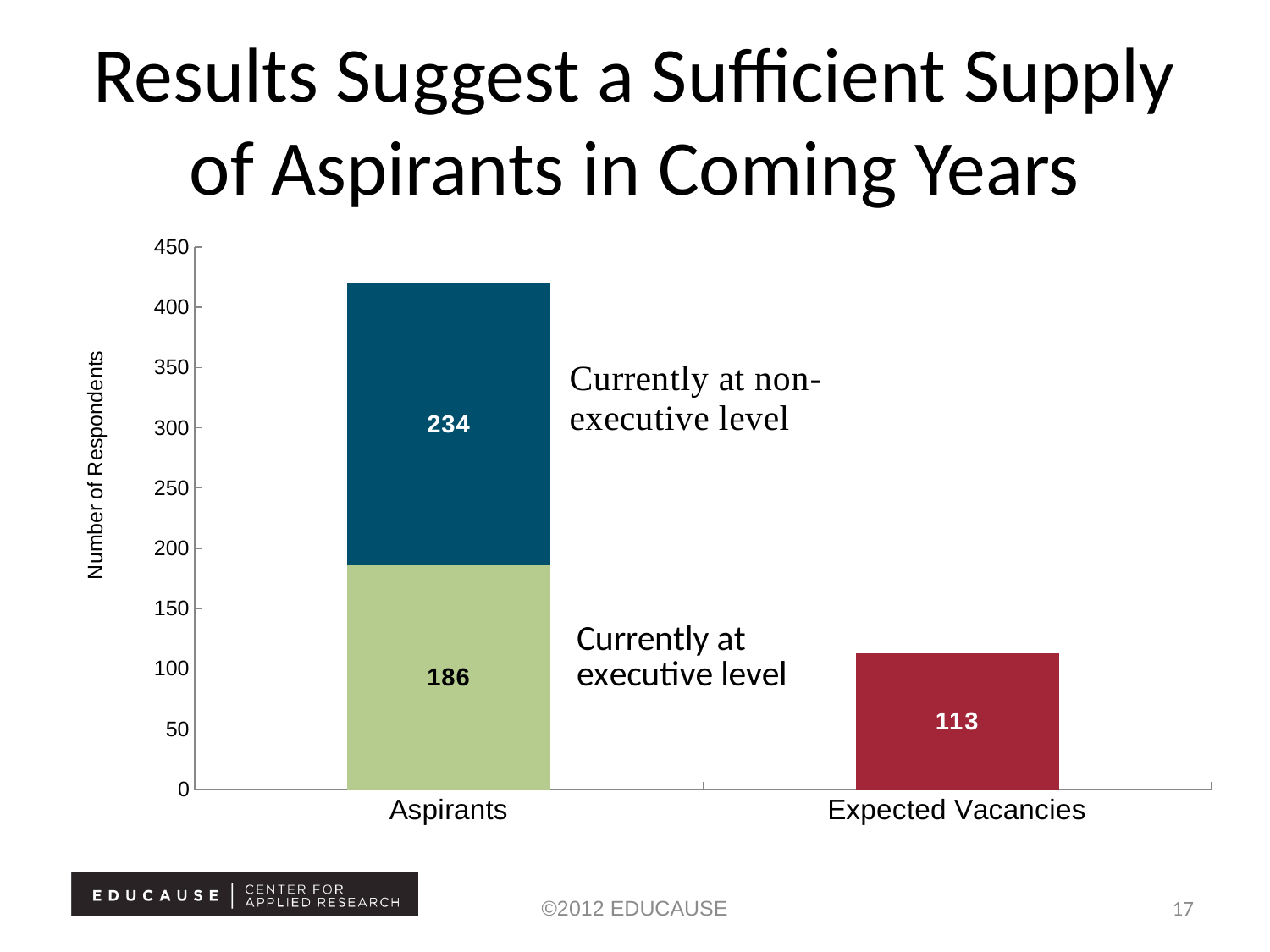
Which is larger: the executive level segment of Aspirants or Expected Vacancies? Executive level segment of Aspirants What kind of chart is shown on the slide? Stacked bar chart What is the difference between the executive level segment of Aspirants (186) and Expected Vacancies (113)? 73 What is the label of the y axis? Number of Respondents What is the difference between the non-executive level segment (234) and the executive level segment (186) of the Aspirants bar? 48 What is the value for the 'Currently at non-executive level' segment of the Aspirants bar? 234 How many categories are shown on the x axis? 2 Which category has the taller bar, Aspirants or Expected Vacancies? Aspirants What is the total of the stacked Aspirants bar? 420 What is the value for Expected Vacancies? 113 What is the value for the 'Currently at executive level' segment of the Aspirants bar? 186 Is the total height of the Aspirants bar greater or less than 400? greater